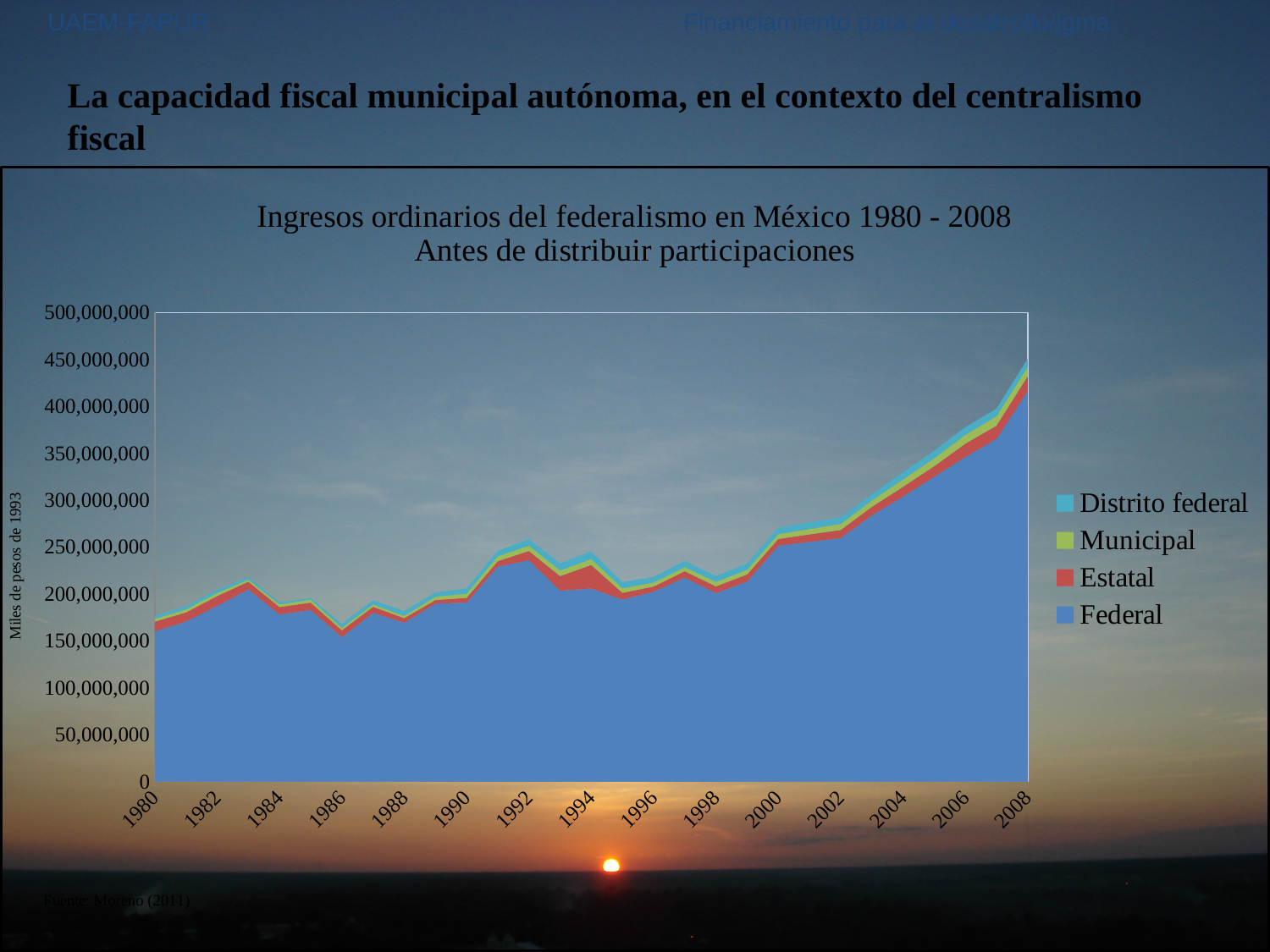
What kind of chart is shown on the slide? Stacked area chart Is the total stacked value for 2000 greater or less than 250,000,000? greater Overall, do the total values rise or fall from 1980 to 2008? rise Is the total stacked value for 2004 greater or less than 350,000,000? less Is the total stacked value for 1986 greater or less than 200,000,000? less Which series accounts for the largest share of the stacked total across the years? Federal Which year has the higher total stacked value, 1980 or 2008? 2008 How many series does the legend list? 4 What is the title of the chart? Ingresos ordinarios del federalismo en México 1980 - 2008 Antes de distribuir participaciones What is the label on the vertical axis of the chart? Miles de pesos de 1993